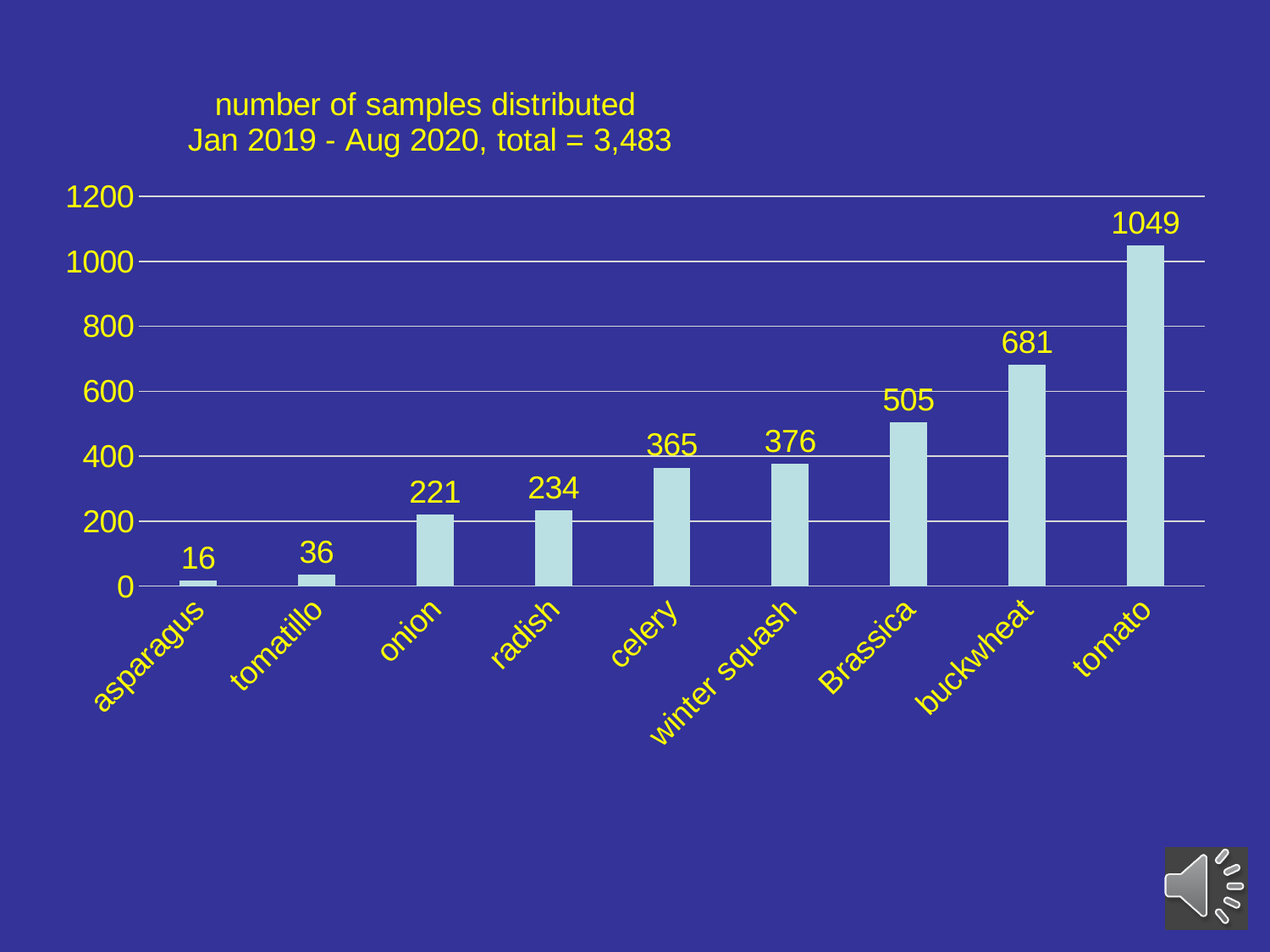
Which has a larger value, Brassica or celery? Brassica Do the values rise or fall from left to right along the x axis? rise What is the difference between the values for radish and onion? 13 Is the value for buckwheat greater or less than 600? greater How many categories are shown on the x axis? 9 How many samples were distributed for onion? 221 What is the value shown for buckwheat? 681 Which category has the lowest number of samples distributed? asparagus What is the value shown for winter squash? 376 What kind of chart is shown on the slide? bar chart What is the difference between the values for tomato and buckwheat? 368 Which category has the highest number of samples distributed? tomato